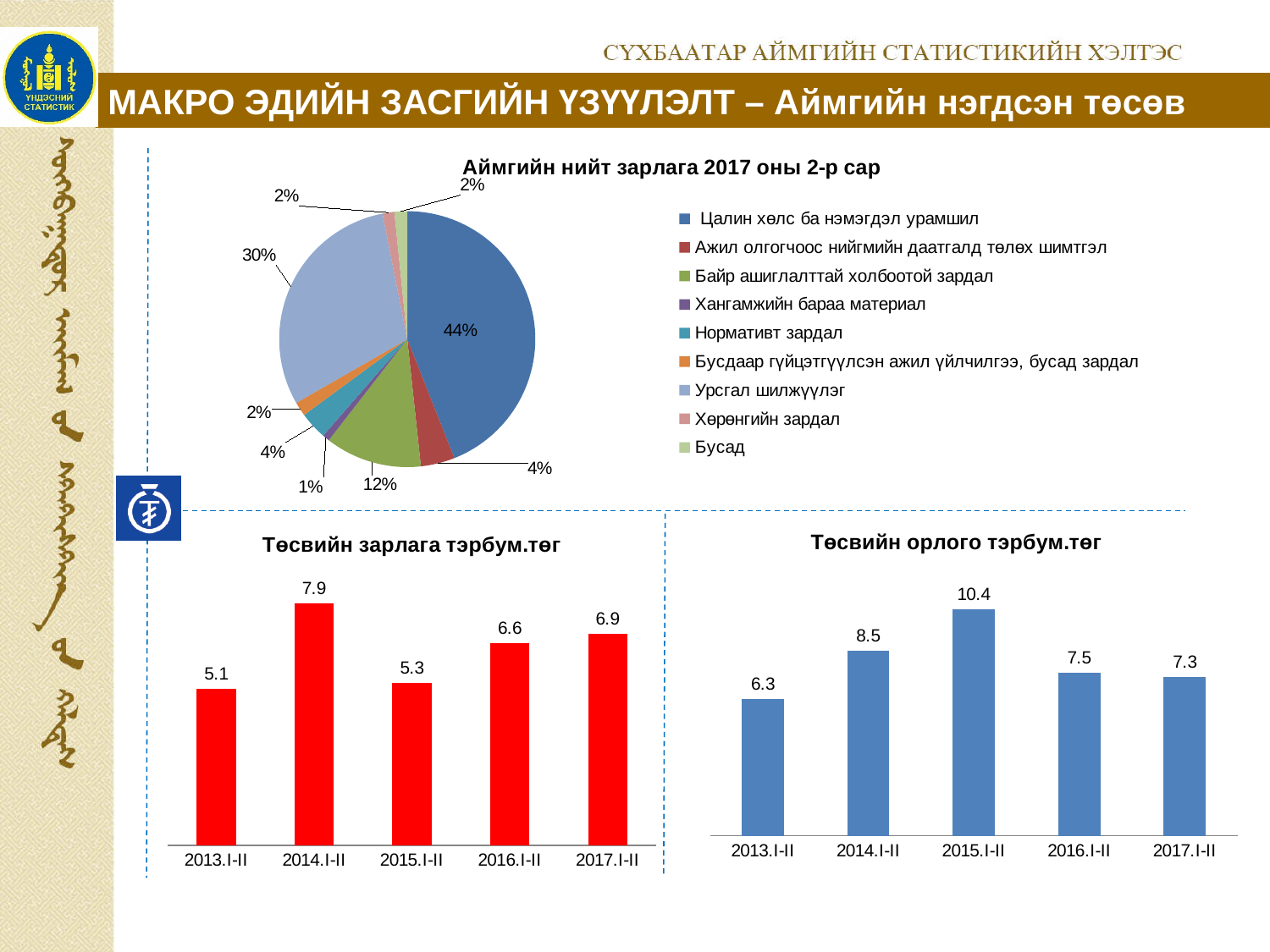
In the chart 'Төсвийн орлого тэрбум.төг', which is larger: the value for 2014.I-II or 2016.I-II? 2014.I-II In the pie chart 'Аймгийн нийт зарлага 2017 оны 2-р сар', how many entries does the legend list? 9 What kind of chart is 'Төсвийн зарлага тэрбум.төг'? bar chart In the chart 'Төсвийн зарлага тэрбум.төг', what is the value for 2014.I-II? 7.9 In the chart 'Төсвийн орлого тэрбум.төг', which period has the highest value? 2015.I-II In the chart 'Төсвийн орлого тэрбум.төг', what is the value for 2015.I-II? 10.4 In the pie chart 'Аймгийн нийт зарлага 2017 оны 2-р сар', which category has the largest slice? Цалин хөлс ба нэмэгдэл урамшил In the pie chart 'Аймгийн нийт зарлага 2017 оны 2-р сар', what share does 'Цалин хөлс ба нэмэгдэл урамшил' have? 44% In the pie chart 'Аймгийн нийт зарлага 2017 оны 2-р сар', what share does 'Урсгал шилжүүлэг' have? 30% In the chart 'Төсвийн орлого тэрбум.төг', how many periods are shown on the x axis? 5 In the chart 'Төсвийн зарлага тэрбум.төг', what is the difference between 2017.I-II and 2016.I-II? 0.3 In the chart 'Төсвийн зарлага тэрбум.төг', which period has the lowest value? 2013.I-II